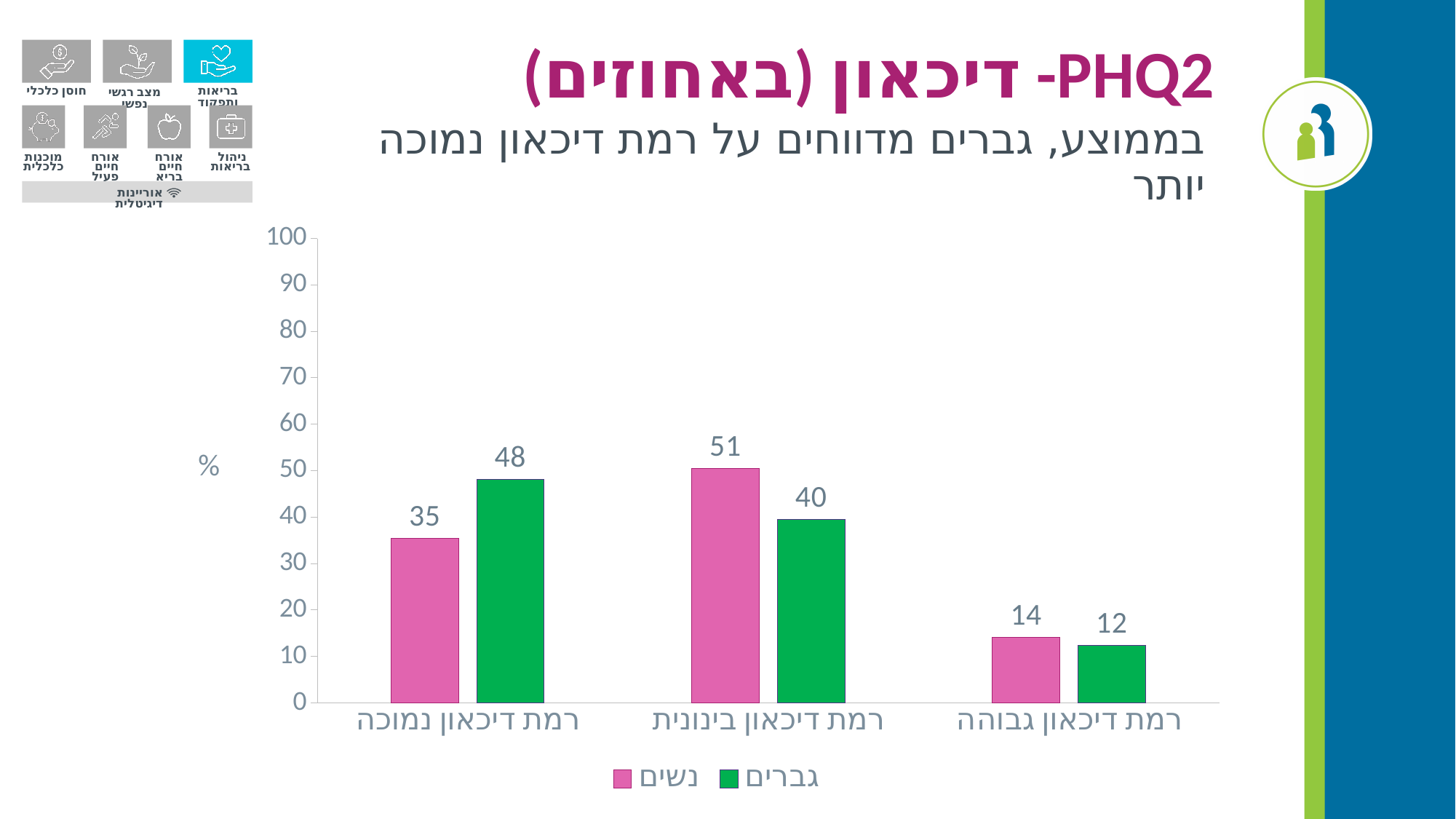
What kind of chart is shown on the slide? bar chart What is the value for גברים in the category רמת דיכאון גבוהה? 12 What is the value for נשים in the category רמת דיכאון נמוכה? 35 What colour are the bars for נשים? pink What is the value for גברים in the category רמת דיכאון נמוכה? 48 Which category has the highest value for נשים? רמת דיכאון בינונית What is the difference between גברים and נשים in the category רמת דיכאון נמוכה? 13 Which category has the lowest value for גברים? רמת דיכאון גבוהה In the category רמת דיכאון בינונית, which series has the larger value, נשים or גברים? נשים What is the value for נשים in the category רמת דיכאון בינונית? 51 How many series does the legend list? 2 How many categories are shown on the x axis? 3